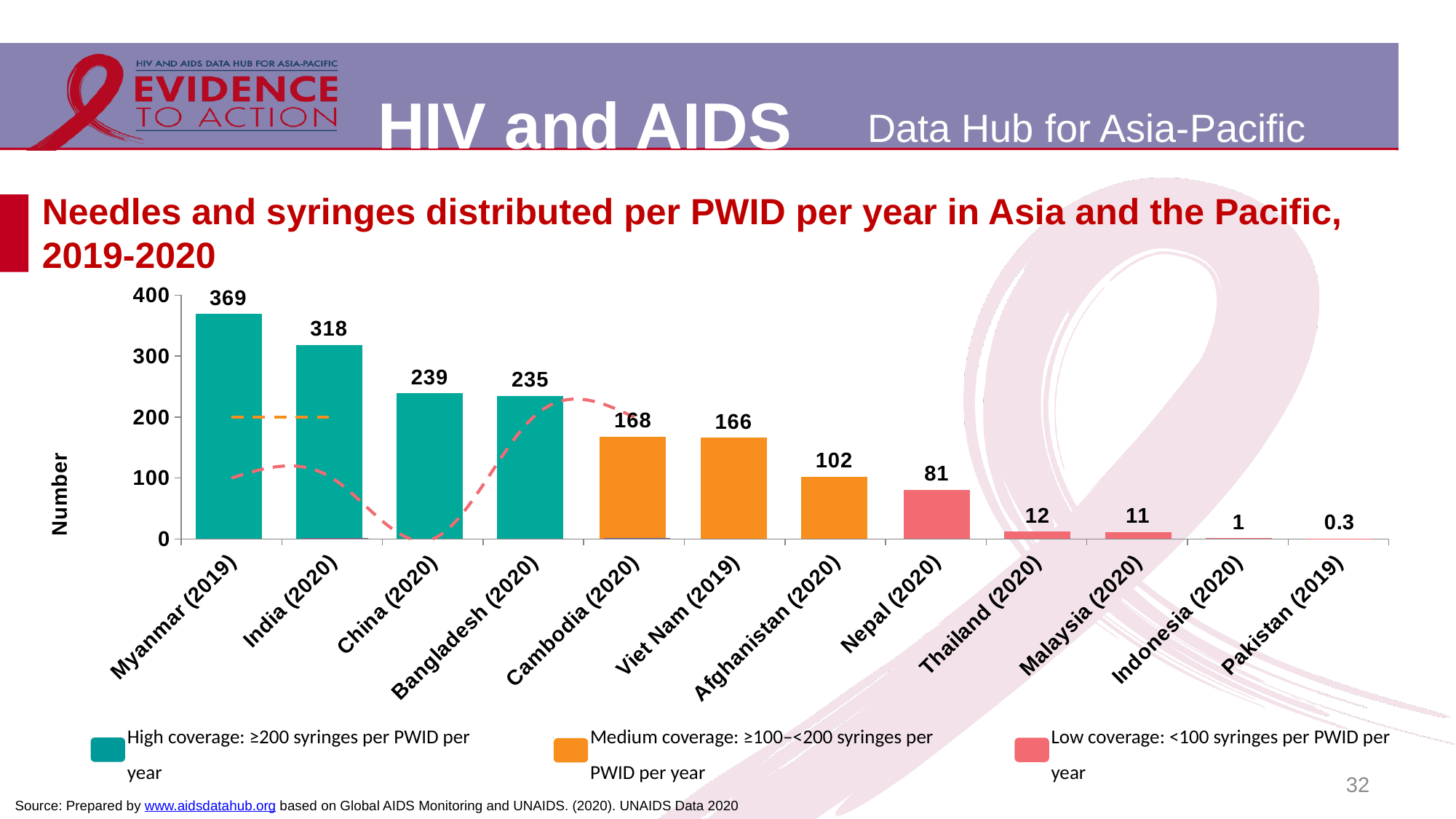
How many countries are shown on the chart? 12 Which country has the lowest number of needles and syringes distributed per PWID per year? Pakistan (2019) What is the value for Cambodia (2020)? 168 What colour are the bars for countries with high coverage (≥200 syringes per PWID per year)? Teal (green) Is the value for Viet Nam (2019) greater or less than 200? less What is the value for Myanmar (2019)? 369 What is the value for Pakistan (2019)? 0.3 What kind of chart is shown on the slide? Bar chart Which is larger, the value for Afghanistan (2020) or the value for Nepal (2020)? Afghanistan (2020) Which country has the highest number of needles and syringes distributed per PWID per year? Myanmar (2019) What is the difference between the values for India (2020) and China (2020)? 79 How many coverage categories does the legend list? 3